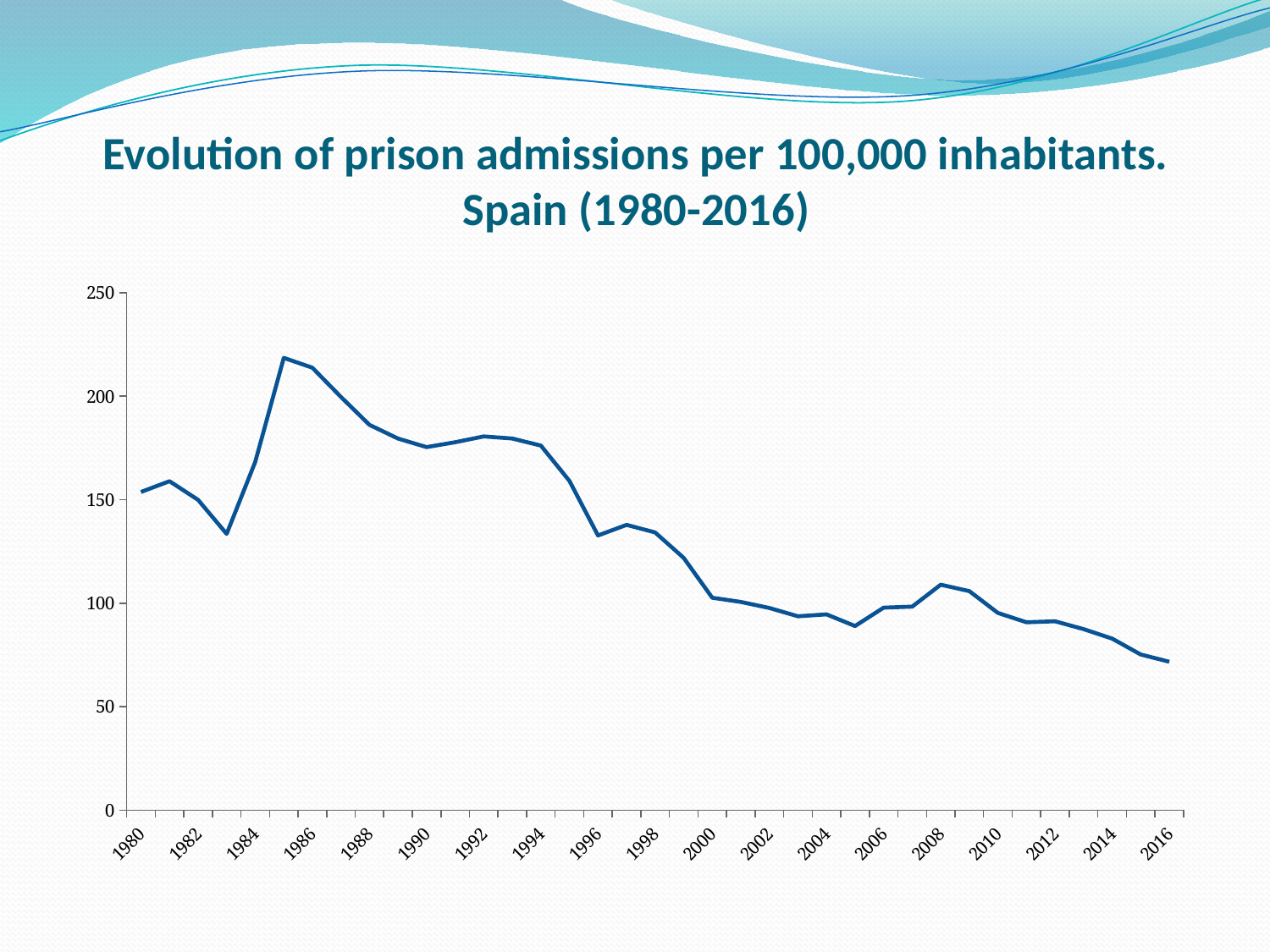
In which year does the line reach its lowest value? 2016 Is the value for 2016 greater or less than 100? less Is the value for 1985 greater or less than 200? greater Overall, do the values rise or fall from 1980 to 2016? fall What kind of chart is shown on the slide? line chart Is the value for 1990 greater or less than 150? greater What is the title of the chart? Evolution of prison admissions per 100,000 inhabitants. Spain (1980-2016) In which year does the line reach its highest value? 1985 How many year labels are shown on the x axis? 19 Which year has the larger value, 1990 or 2000? 1990